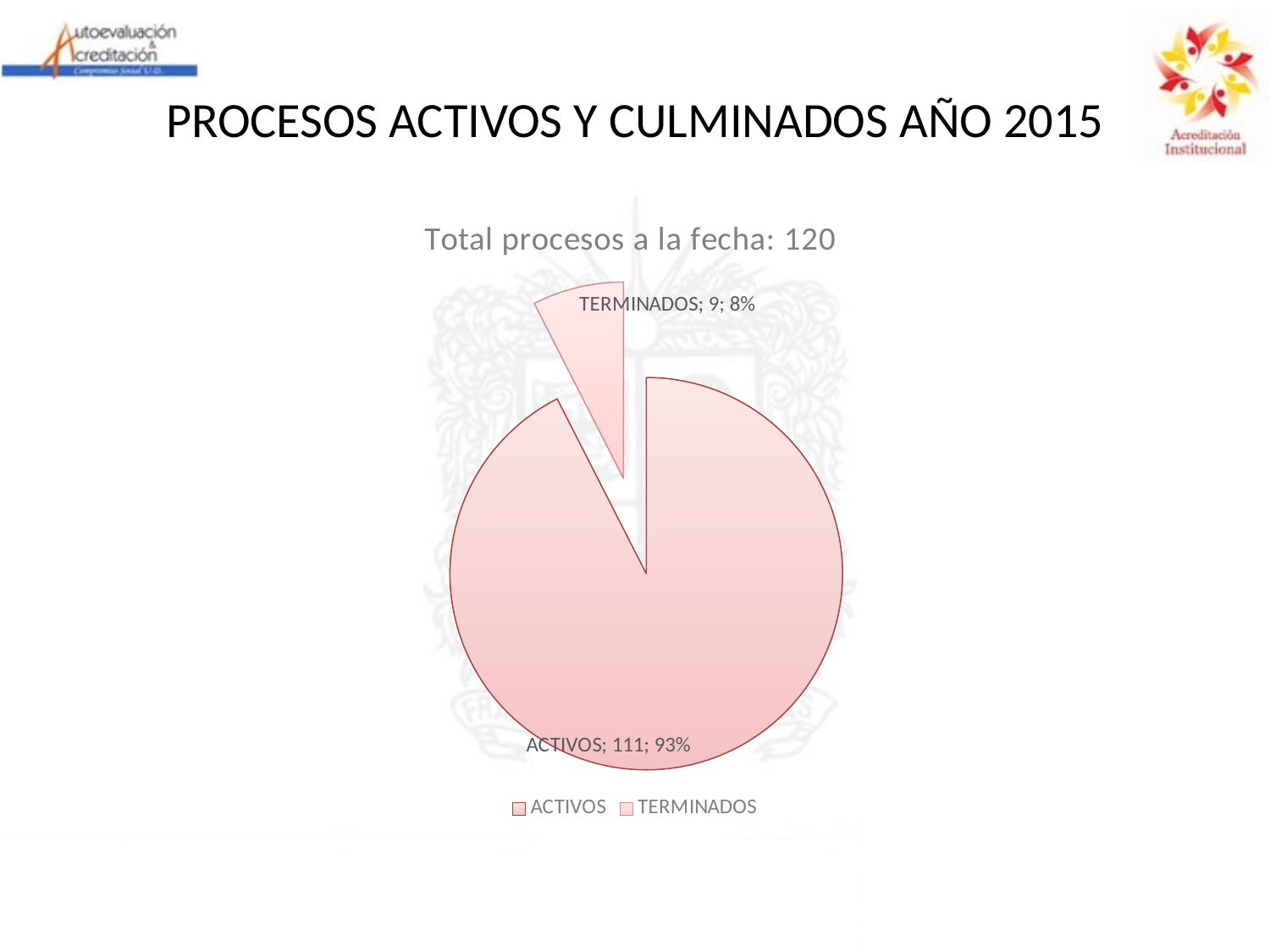
Which category has the largest slice of the pie? ACTIVOS What is the difference between the values for ACTIVOS and TERMINADOS? 102 What kind of chart is shown on the slide? pie chart What share of the pie does the ACTIVOS slice represent? 93% Which is larger, the value for ACTIVOS or the value for TERMINADOS? ACTIVOS What is the value for ACTIVOS? 111 How many entries does the legend list? 2 How many slices does the pie chart have? 2 What is the title of the chart? Total procesos a la fecha: 120 Which category has the smallest slice of the pie? TERMINADOS What is the value for TERMINADOS? 9 What share of the pie does the TERMINADOS slice represent? 8%